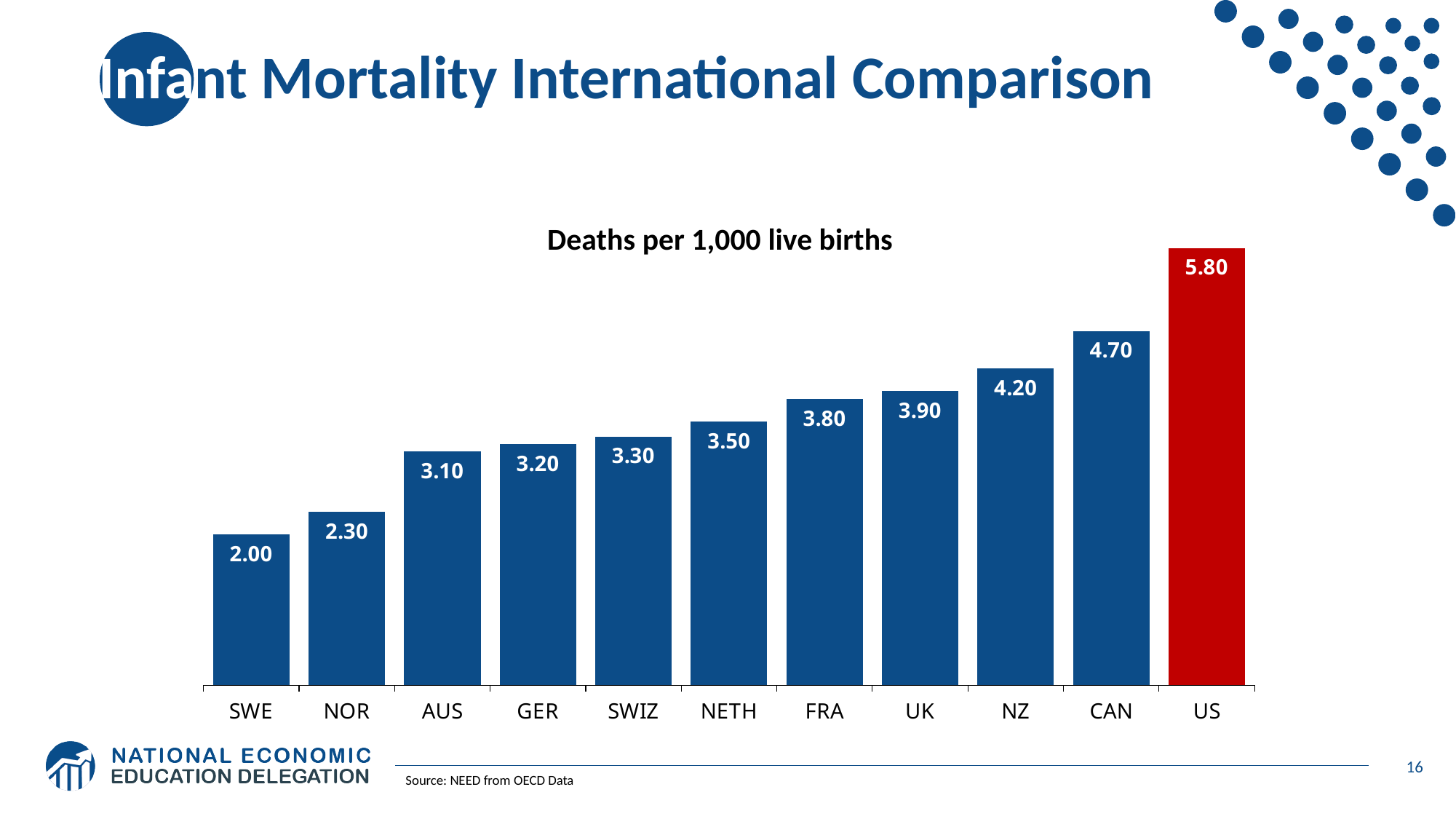
What is the value for NZ? 4.20 How many countries are shown on the chart? 11 Which country has the lowest value? SWE Which country has the highest value? US What is the difference between the values for AUS and SWE? 1.10 What is the difference between the values for the US and CAN? 1.10 What is the value for the US? 5.80 What is the title of the chart? Deaths per 1,000 live births Do the values rise or fall from left to right along the x axis? Rise What kind of chart is this? Bar chart Which has a larger value, FRA or NETH? FRA What is the value for GER? 3.20